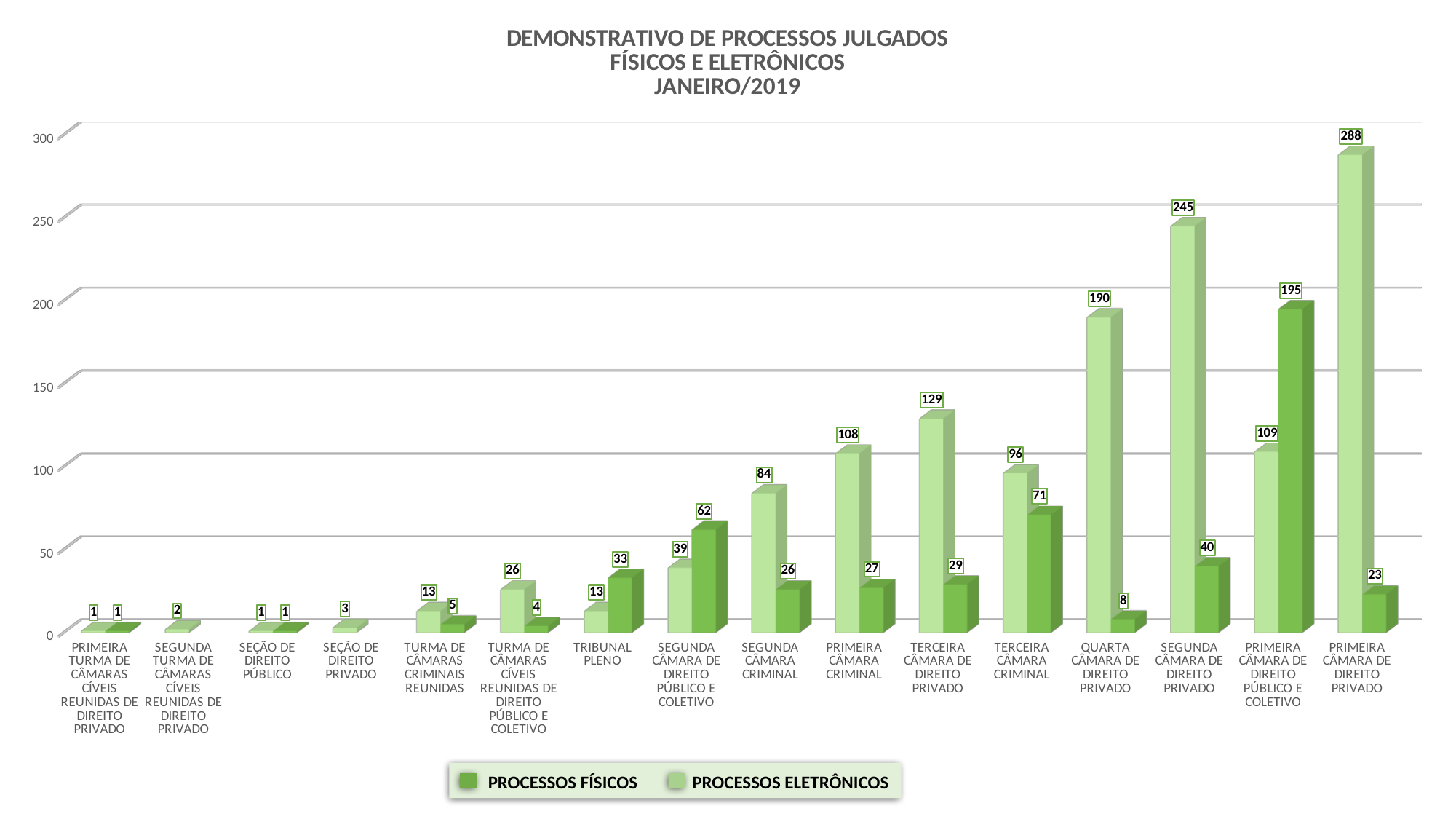
How many categories are shown on the x axis? 16 Which category has the highest value for PROCESSOS FÍSICOS? PRIMEIRA CÂMARA DE DIREITO PÚBLICO E COLETIVO What is the value of PROCESSOS FÍSICOS for TRIBUNAL PLENO? 33 What is the value of PROCESSOS ELETRÔNICOS for PRIMEIRA CÂMARA DE DIREITO PRIVADO? 288 How many series does the legend list? 2 What is the difference between PROCESSOS ELETRÔNICOS and PROCESSOS FÍSICOS for SEGUNDA CÂMARA DE DIREITO PRIVADO? 205 What is the title of the chart? DEMONSTRATIVO DE PROCESSOS JULGADOS FÍSICOS E ELETRÔNICOS JANEIRO/2019 What is the value of PROCESSOS FÍSICOS for PRIMEIRA CÂMARA DE DIREITO PÚBLICO E COLETIVO? 195 For TERCEIRA CÂMARA CRIMINAL, which is larger: PROCESSOS FÍSICOS or PROCESSOS ELETRÔNICOS? PROCESSOS ELETRÔNICOS Which category has the highest value for PROCESSOS ELETRÔNICOS? PRIMEIRA CÂMARA DE DIREITO PRIVADO What type of chart is shown on the slide? Bar chart Is the value of PROCESSOS ELETRÔNICOS for QUARTA CÂMARA DE DIREITO PRIVADO greater or less than 150? greater